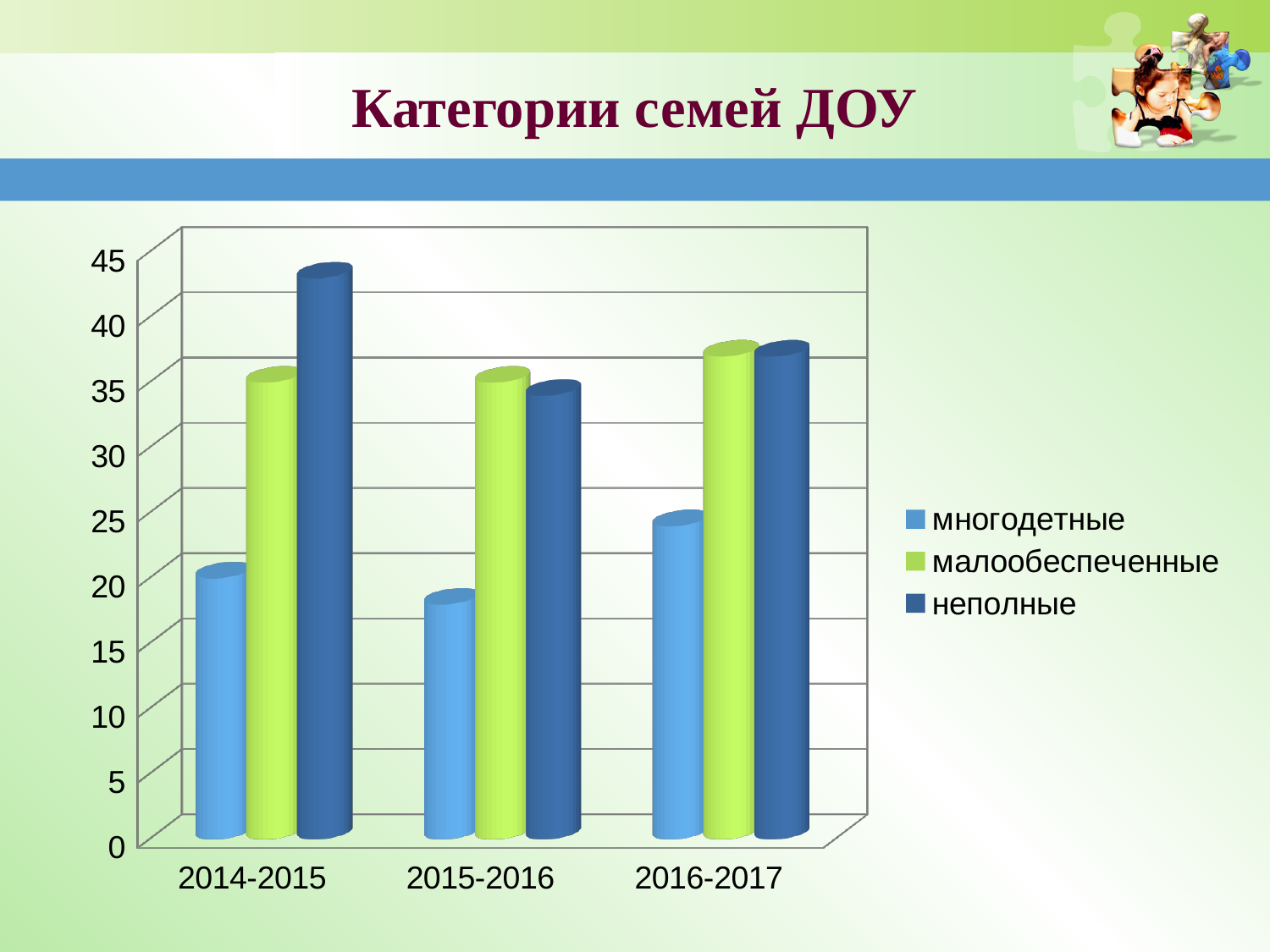
Is the value for малообеспеченные in 2015-2016 greater or less than 30? greater Which series has the highest value in 2014-2015? неполные How many series does the legend list? 3 What kind of chart is shown on the slide? bar chart Which is larger: the value for неполные in 2014-2015 or in 2015-2016? 2014-2015 What is the title of the chart on the slide? Категории семей ДОУ How many categories (school years) are shown on the x axis? 3 Is the value for многодетные in 2014-2015 greater or less than 25? less Is the value for неполные in 2014-2015 greater or less than 40? greater Which series has the lowest value in 2016-2017? многодетные In which year is the value for многодетные the highest? 2016-2017 In which year is the value for неполные the highest? 2014-2015